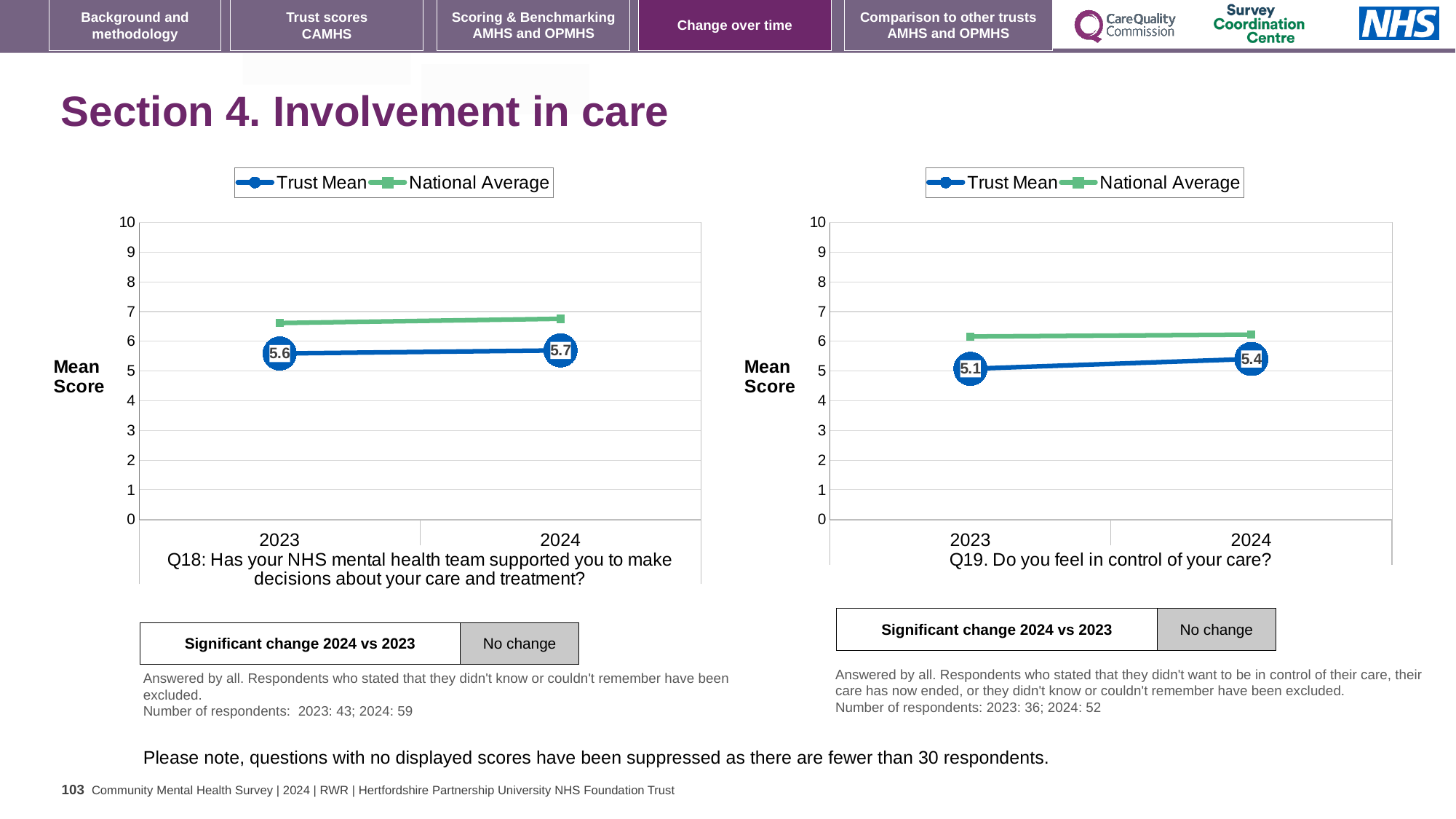
In the left chart (Q18), what is the Trust Mean score for 2023? 5.6 In the right chart (Q19), what is the Trust Mean score for 2024? 5.4 In the left chart (Q18), does the Trust Mean rise or fall from 2023 to 2024? rise In the right chart (Q19), by how much did the Trust Mean change from 2023 to 2024? 0.3 In the right chart (Q19), is the National Average for 2023 greater or less than 6? greater In the right chart (Q19), what is the Trust Mean score for 2023? 5.1 What are the two series named in the legend of the left chart (Q18)? Trust Mean and National Average How many years are shown on the x axis of the left chart (Q18)? 2 What type of chart is the left chart (Q18)? line chart How many series does the legend of the right chart (Q19) list? 2 In the left chart (Q18), what is the Trust Mean score for 2024? 5.7 In the left chart (Q18), which is higher in 2024, the Trust Mean or the National Average? National Average